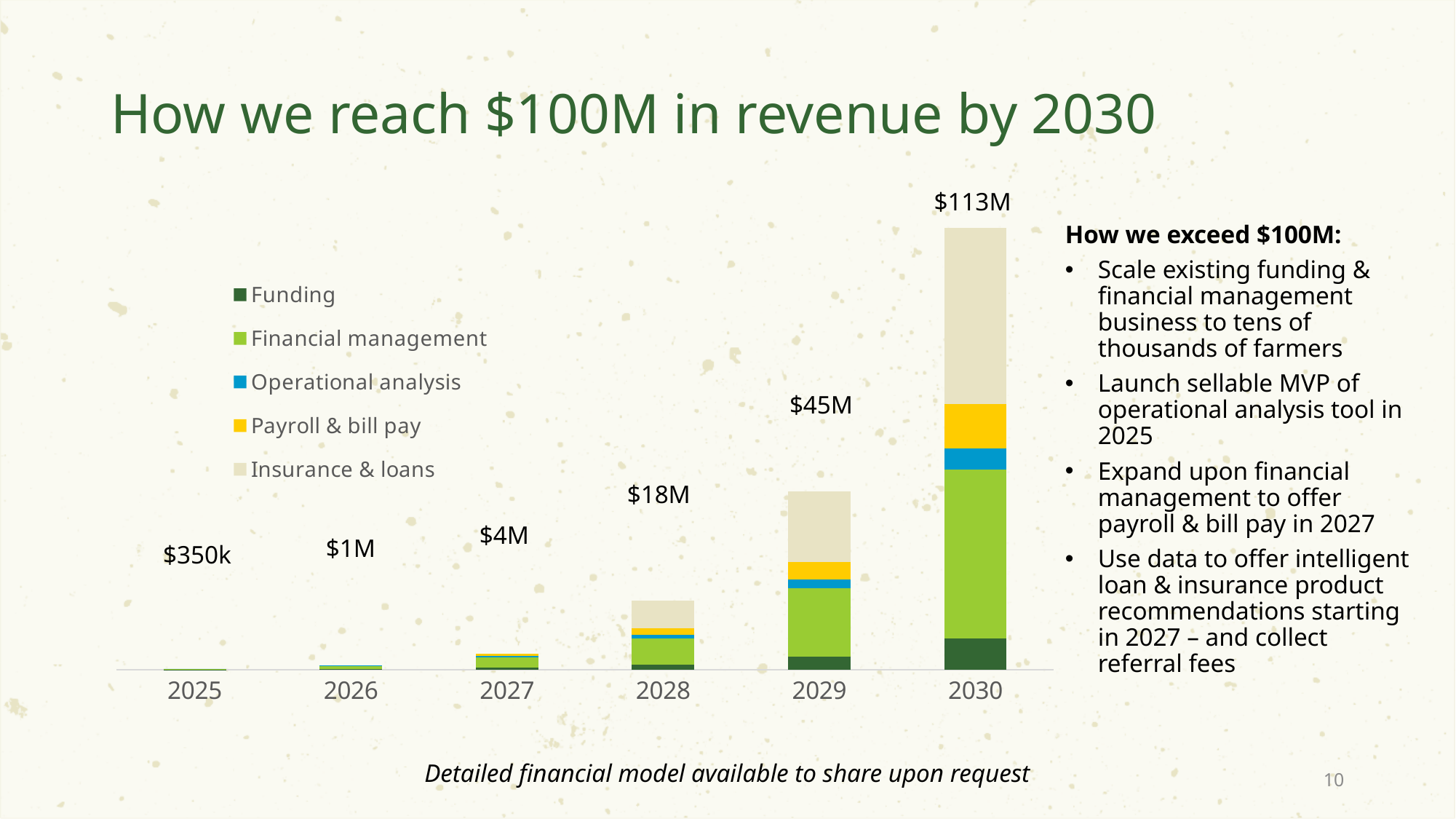
What is the total revenue shown for 2028? $18M What is the difference between the total revenue for 2030 and 2029? $68M Do the total revenue values rise or fall from 2025 to 2030? Rise What is the difference between the total revenue for 2029 and 2028? $27M What is the total revenue shown for 2030? $113M What is the total revenue shown for 2025? $350k How many years are shown on the x axis? 6 Which year has a larger total revenue, 2027 or 2028? 2028 How many series does the legend list? 5 Which year has the highest total revenue? 2030 What kind of chart is shown on the slide? Stacked bar chart Which year has the lowest total revenue? 2025